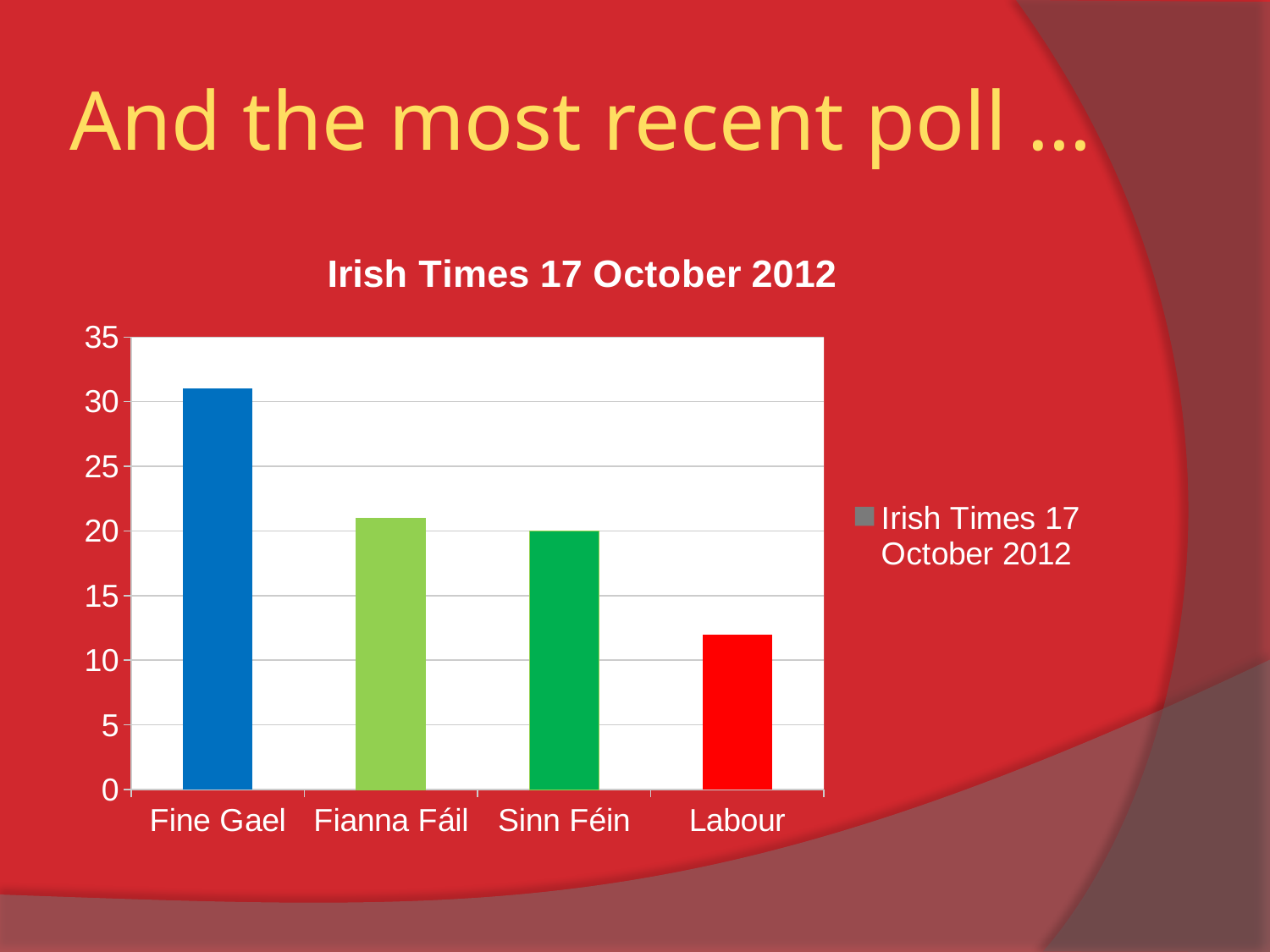
How many series does the legend list? 1 Is the value for Labour greater or less than 15? less What is the title of the chart? Irish Times 17 October 2012 Which party has the lowest value in the chart? Labour Is the value for Fianna Fáil greater or less than 25? less How many parties are shown on the x axis of the chart? 4 Which is larger, the value for Fine Gael or the value for Labour? Fine Gael Is the value for Fine Gael greater or less than 30? greater What is the value for Sinn Féin? 20 Do the values rise or fall moving from left to right along the x axis? fall Which party has the highest value in the chart? Fine Gael What kind of chart is shown on the slide? bar chart